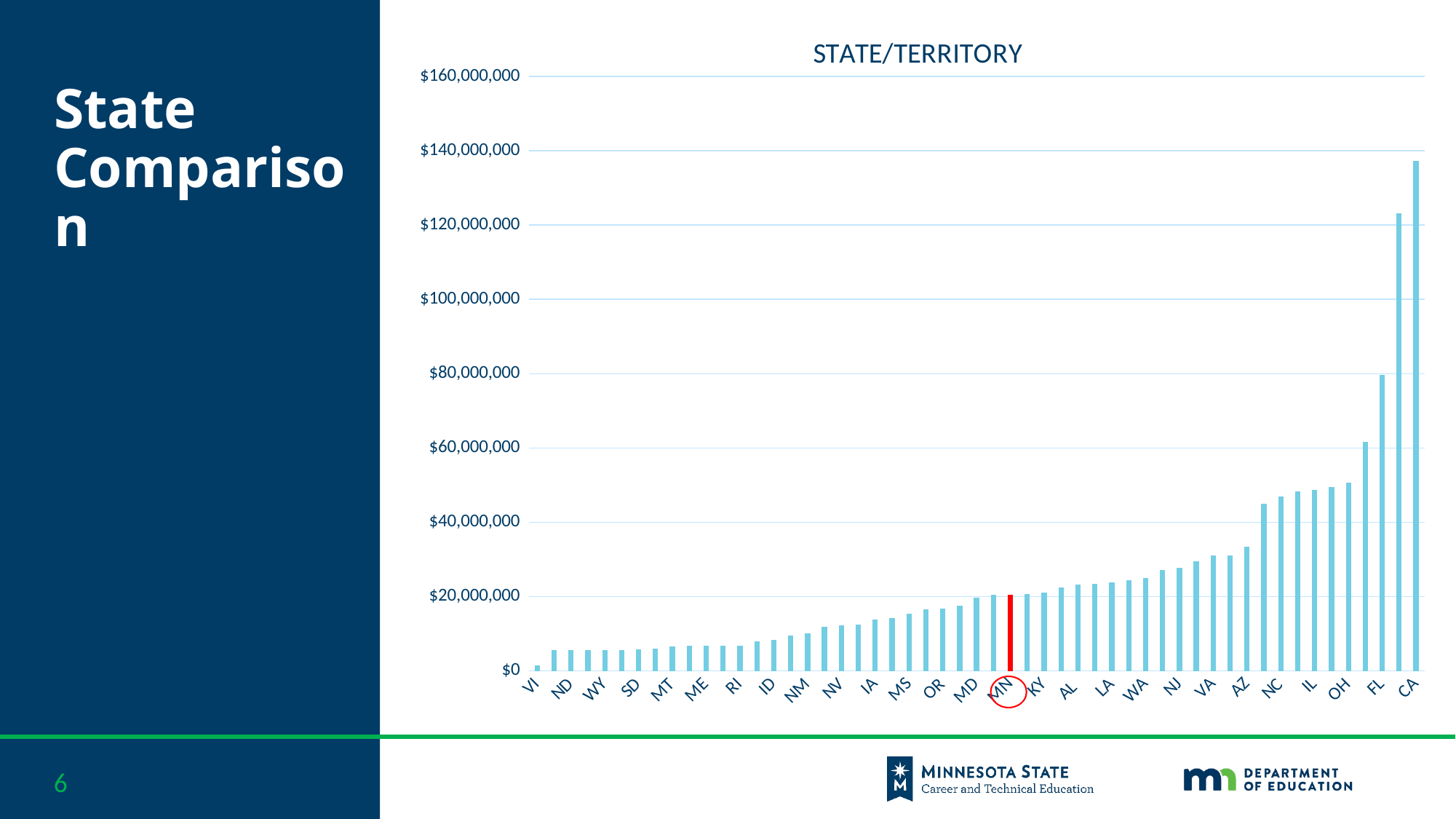
Which state's bar is highlighted in red and circled on the chart? MN Is the value for OH greater or less than $60,000,000? less What kind of chart is shown on the slide? bar chart Which has a larger value, CA or FL? CA Which has a larger value, MN or OH? OH Is the value for CA greater or less than $120,000,000? greater Which state/territory has the lowest value in the chart? VI What is the title of the chart? STATE/TERRITORY Is the value for FL greater or less than $60,000,000? greater Which state/territory has the highest value in the chart? CA Do the values generally rise or fall moving from left to right along the x axis? rise